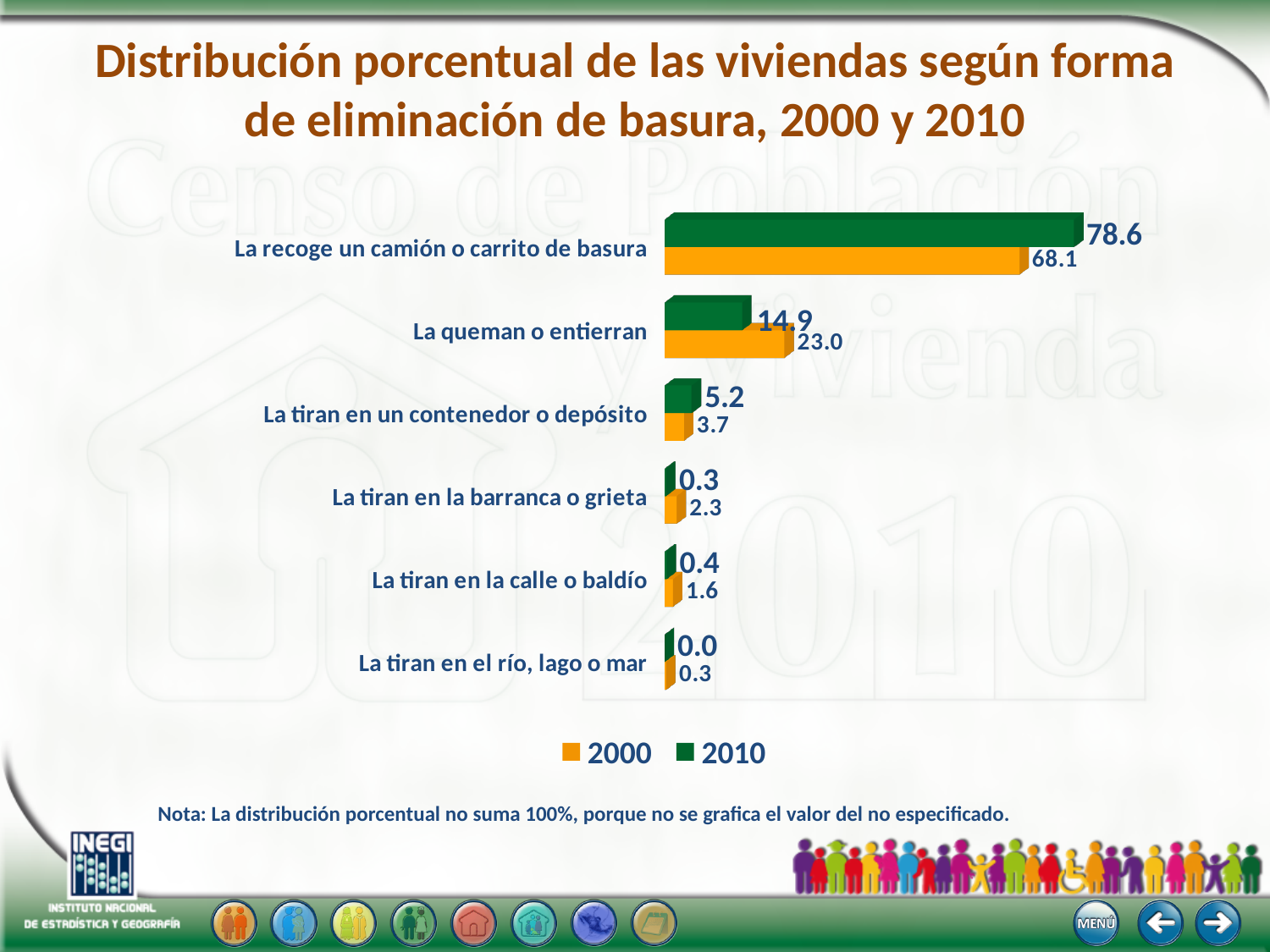
What is the difference between the 2010 and 2000 values for "La recoge un camión o carrito de basura"? 10.5 What is the difference between the 2000 and 2010 values for "La queman o entierran"? 8.1 How many categories are shown in the chart? 6 Which category has the highest 2010 value? La recoge un camión o carrito de basura Which category has the lowest 2000 value? La tiran en el río, lago o mar What is the 2010 value for "La tiran en el río, lago o mar"? 0.0 What is the 2000 value for "La tiran en un contenedor o depósito"? 3.7 What is the 2000 value for "La queman o entierran"? 23.0 What is the 2010 value for "La recoge un camión o carrito de basura"? 78.6 What kind of chart is shown on the slide? Bar chart For "La tiran en la barranca o grieta", which year has the larger value, 2000 or 2010? 2000 How many series does the legend list? 2